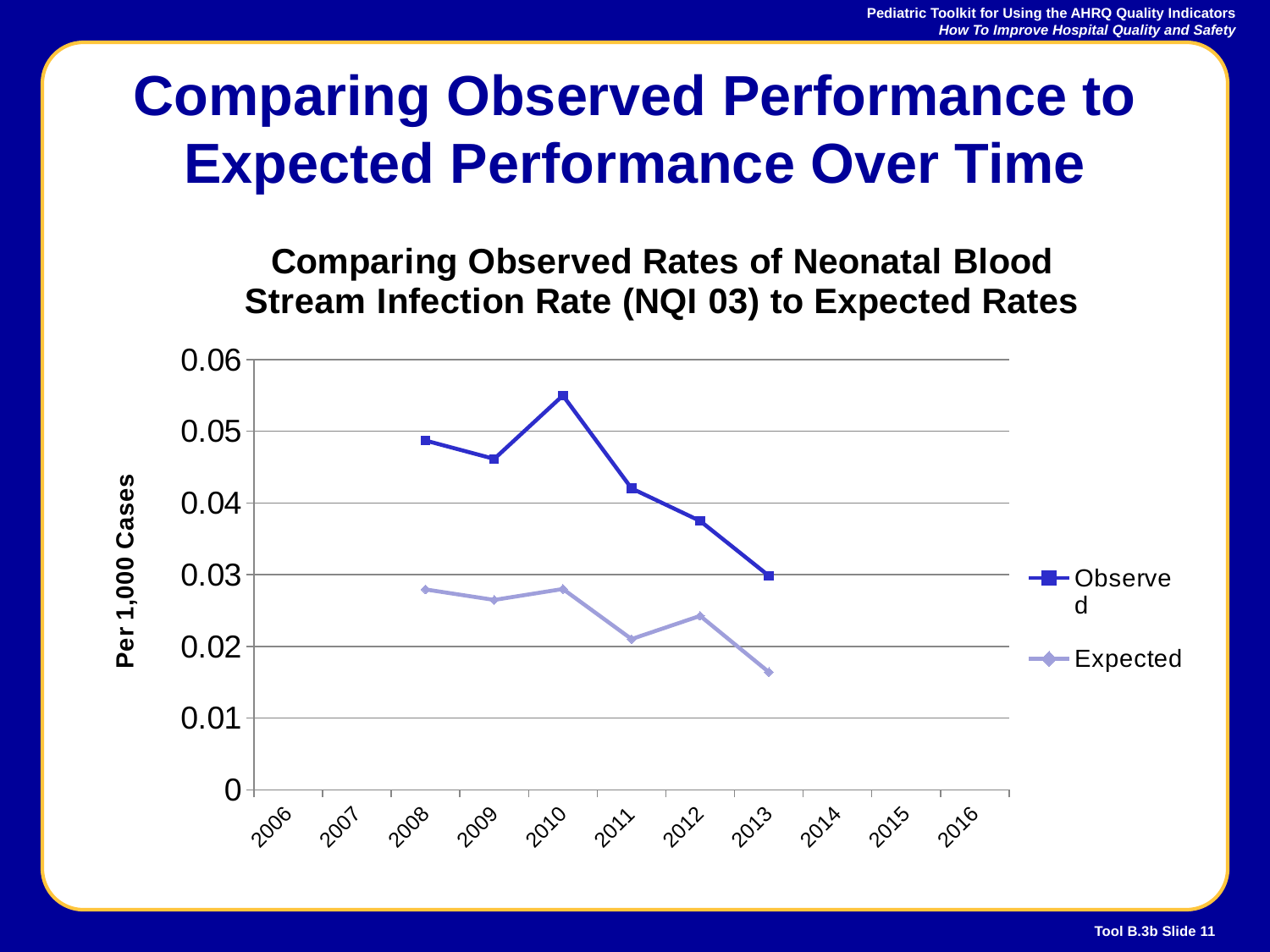
In 2010, which series has the larger value, Observed or Expected? Observed In which year does the Expected series reach its lowest value? 2013 Does the Observed series rise or fall from 2010 to 2013? Fall Is the Observed value for 2012 greater or less than 0.04? less What is the label on the vertical axis? Per 1,000 Cases In which year does the Observed series reach its highest value? 2010 What kind of chart is shown on the slide? Line chart Is the Expected value for 2013 greater or less than 0.02? less In which year does the Observed series reach its lowest value? 2013 How many series does the legend list? 2 Is the Observed value for 2010 greater or less than 0.05? greater What are the two series named in the legend? Observed and Expected